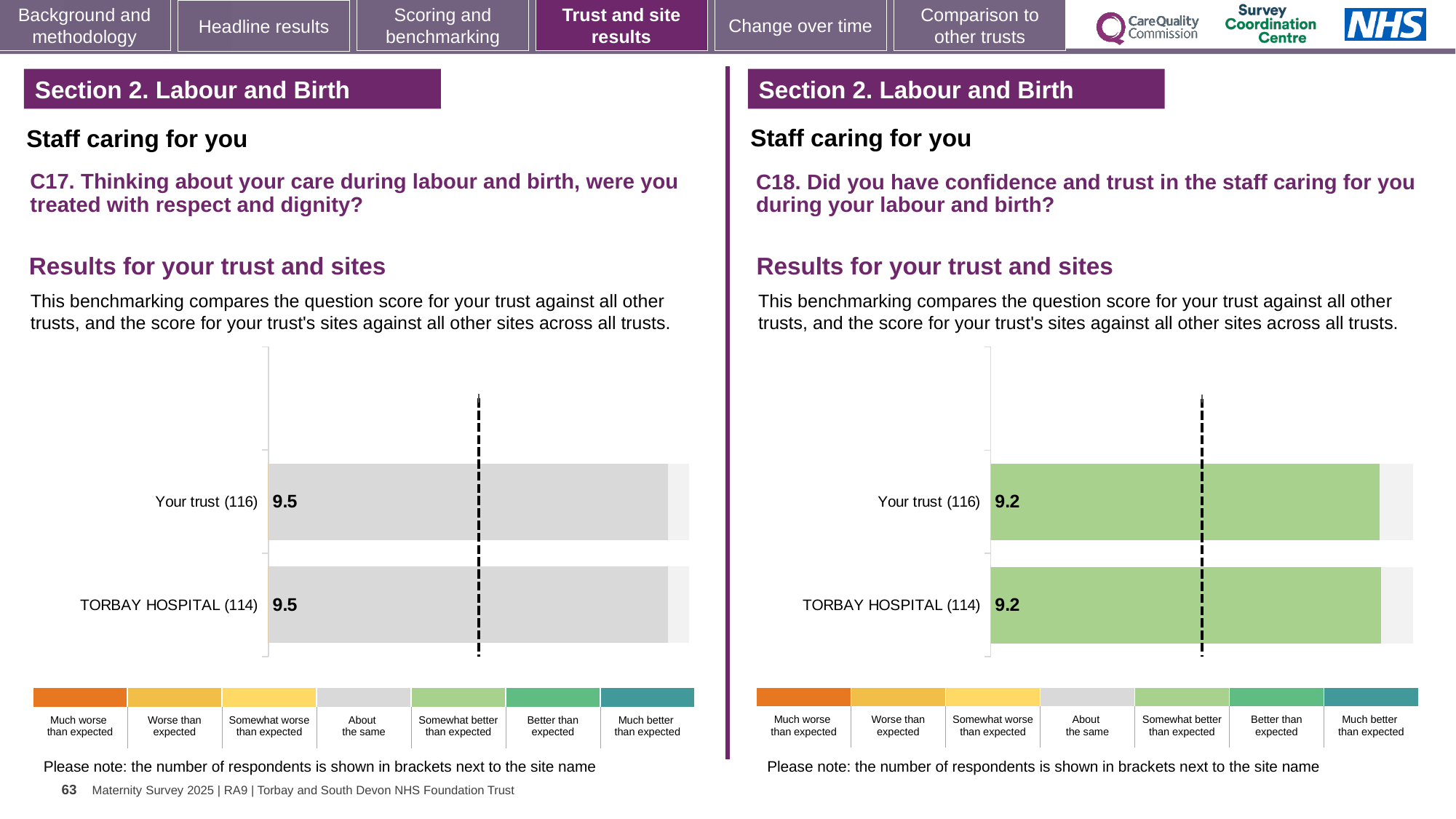
Is the score for Your trust in the C17 chart on the left larger than, smaller than, or equal to the score for Your trust in the C18 chart on the right? Larger In the C17 chart on the left, what is the score for TORBAY HOSPITAL (114)? 9.5 In the C18 chart on the right, what is the difference between the score for Your trust and the score for TORBAY HOSPITAL? 0 In the C17 chart on the left, what is the difference between the score for Your trust and the score for TORBAY HOSPITAL? 0 How many bars are plotted in the C17 chart on the left? 2 In the C18 chart on the right, which benchmark category does the colour of the bars correspond to? Somewhat better than expected In the C17 chart on the left, which benchmark category does the colour of the bars correspond to? About the same In the C17 chart on the left, what is the score for Your trust (116)? 9.5 In the C18 chart on the right, what is the score for Your trust (116)? 9.2 In the C18 chart on the right, what is the score for TORBAY HOSPITAL (114)? 9.2 How many bars are plotted in the C18 chart on the right? 2 What kind of chart is used in the C17 chart on the left? Bar chart